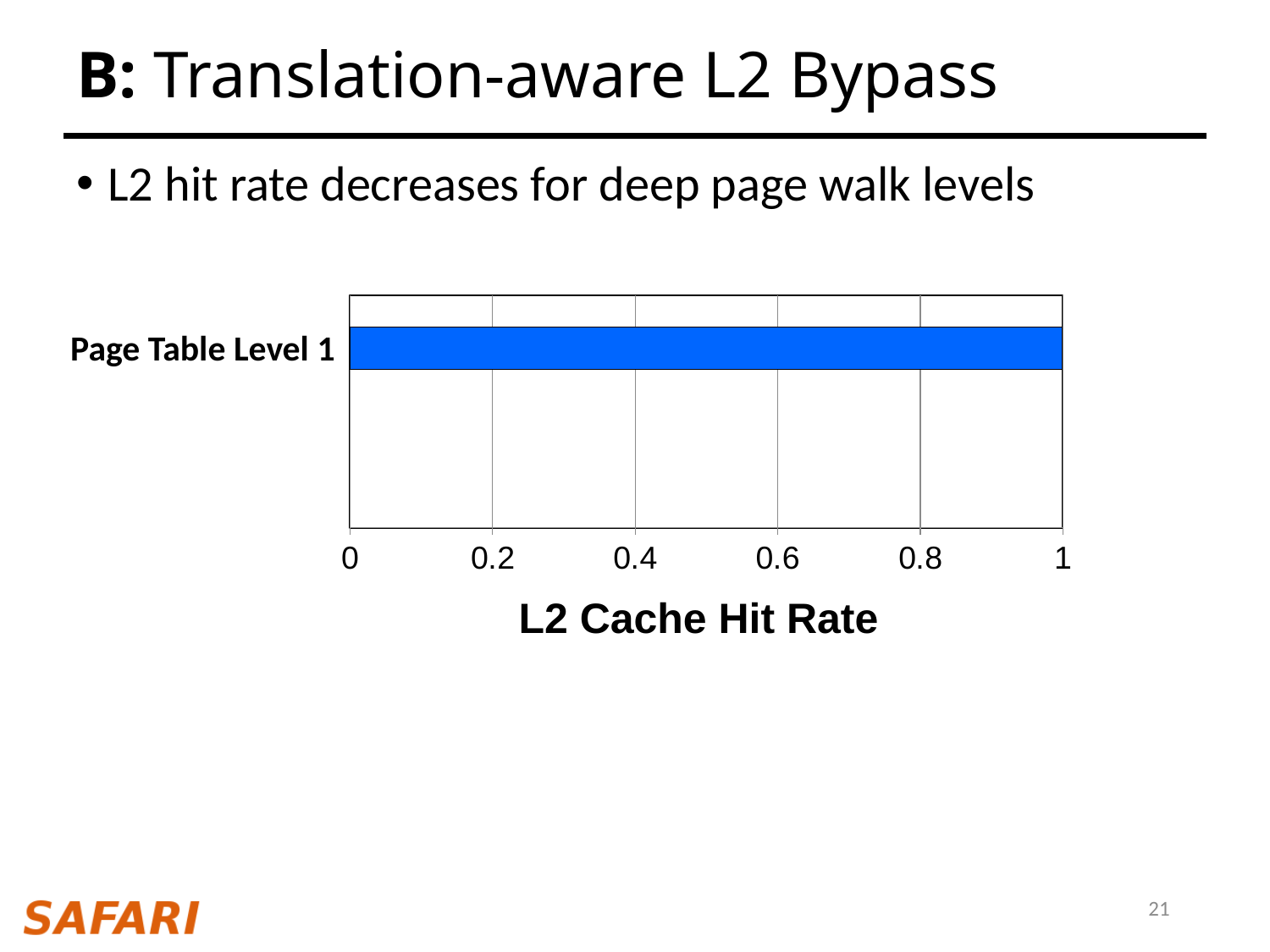
What is the title of the horizontal axis of the chart? L2 Cache Hit Rate What is the highest tick value shown on the horizontal axis? 1 Is the value for Page Table Level 1 greater or less than 0.8? greater How many labeled categories are shown on the chart? 1 What kind of chart is shown on the slide? bar chart Is the value for Page Table Level 1 greater or less than 0.6? greater What is the label of the category plotted on the chart? Page Table Level 1